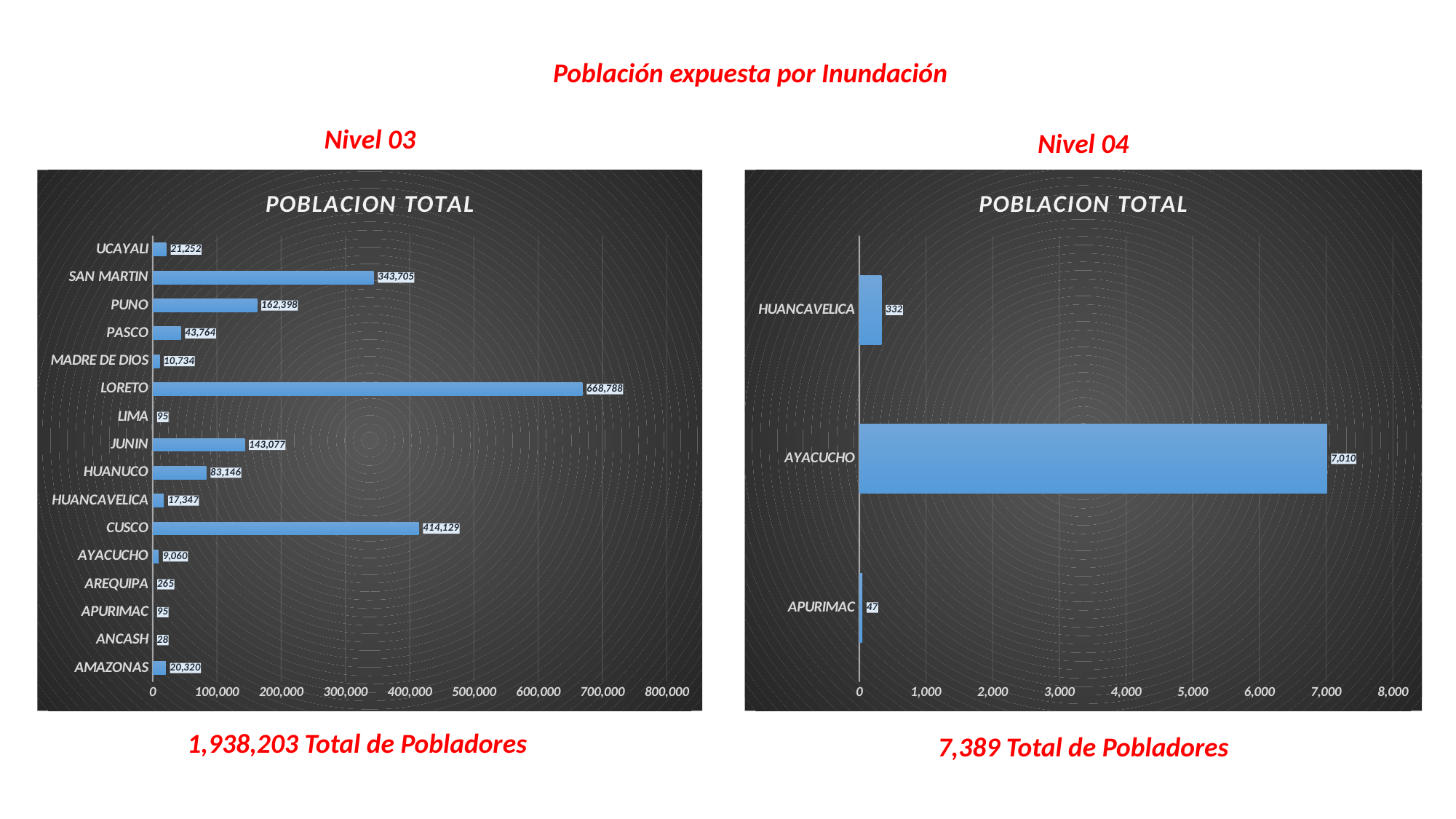
In the Nivel 03 chart on the left, which category has the lowest value? ANCASH In the Nivel 03 chart on the left, what is the difference between the values for LORETO and CUSCO? 254,659 In the Nivel 04 chart on the right, which category has the lowest value? APURIMAC In the Nivel 03 chart on the left, which category has the highest value? LORETO What type of chart is the Nivel 04 chart on the right? Bar chart In the Nivel 04 chart on the right, what is the value for AYACUCHO? 7,010 In the Nivel 03 chart on the left, which is larger, the value for PUNO or the value for JUNIN? PUNO In the Nivel 04 chart on the right, what is the difference between the values for AYACUCHO and HUANCAVELICA? 6,678 In the Nivel 04 chart on the right, what is the value for HUANCAVELICA? 332 In the Nivel 03 chart on the left, what is the value for LORETO? 668,788 In the Nivel 03 chart on the left, what is the value for SAN MARTIN? 343,705 How many categories are shown in the Nivel 03 chart on the left? 16